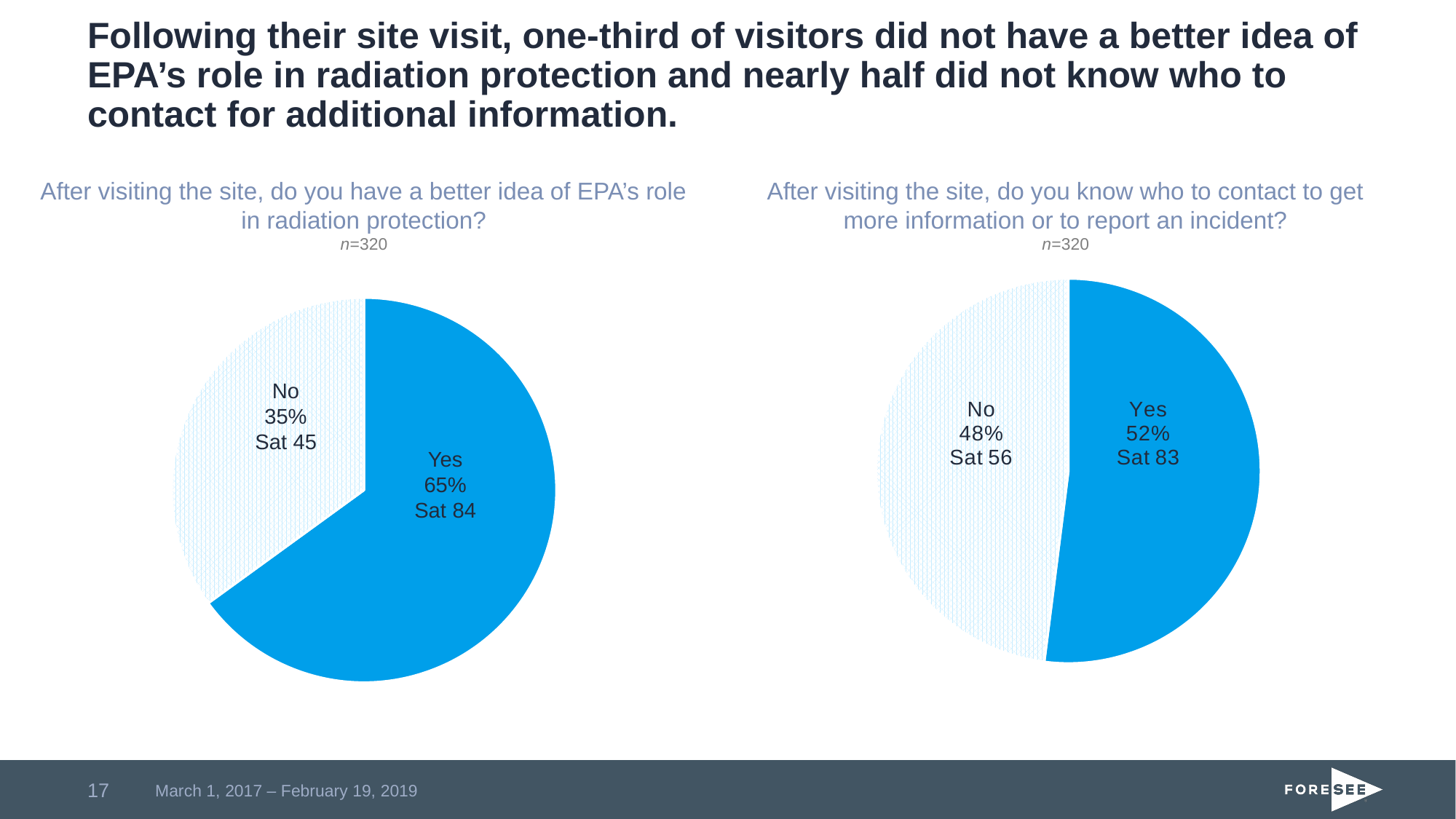
How many slices does the left pie chart (better idea of EPA's role) have? 2 In the left pie chart (better idea of EPA's role), what percentage of respondents answered No? 35% In the left pie chart (better idea of EPA's role), what percentage of respondents answered Yes? 65% In the left pie chart (better idea of EPA's role), what is the difference in percentage points between the Yes and No slices? 30 In the right pie chart (know who to contact), what percentage of respondents answered No? 48% In the left pie chart (better idea of EPA's role), which slice is the largest? Yes In the right pie chart (know who to contact), what is the Sat score for the No slice? 56 What is the sample size (n) shown for the right pie chart (know who to contact)? 320 What type of chart is used on this slide? Pie chart In the right pie chart (know who to contact), what is the difference between the Sat scores of the Yes and No slices? 27 In the right pie chart (know who to contact), which slice is larger, Yes or No? Yes In the left pie chart (better idea of EPA's role), what is the Sat score for the Yes slice? 84